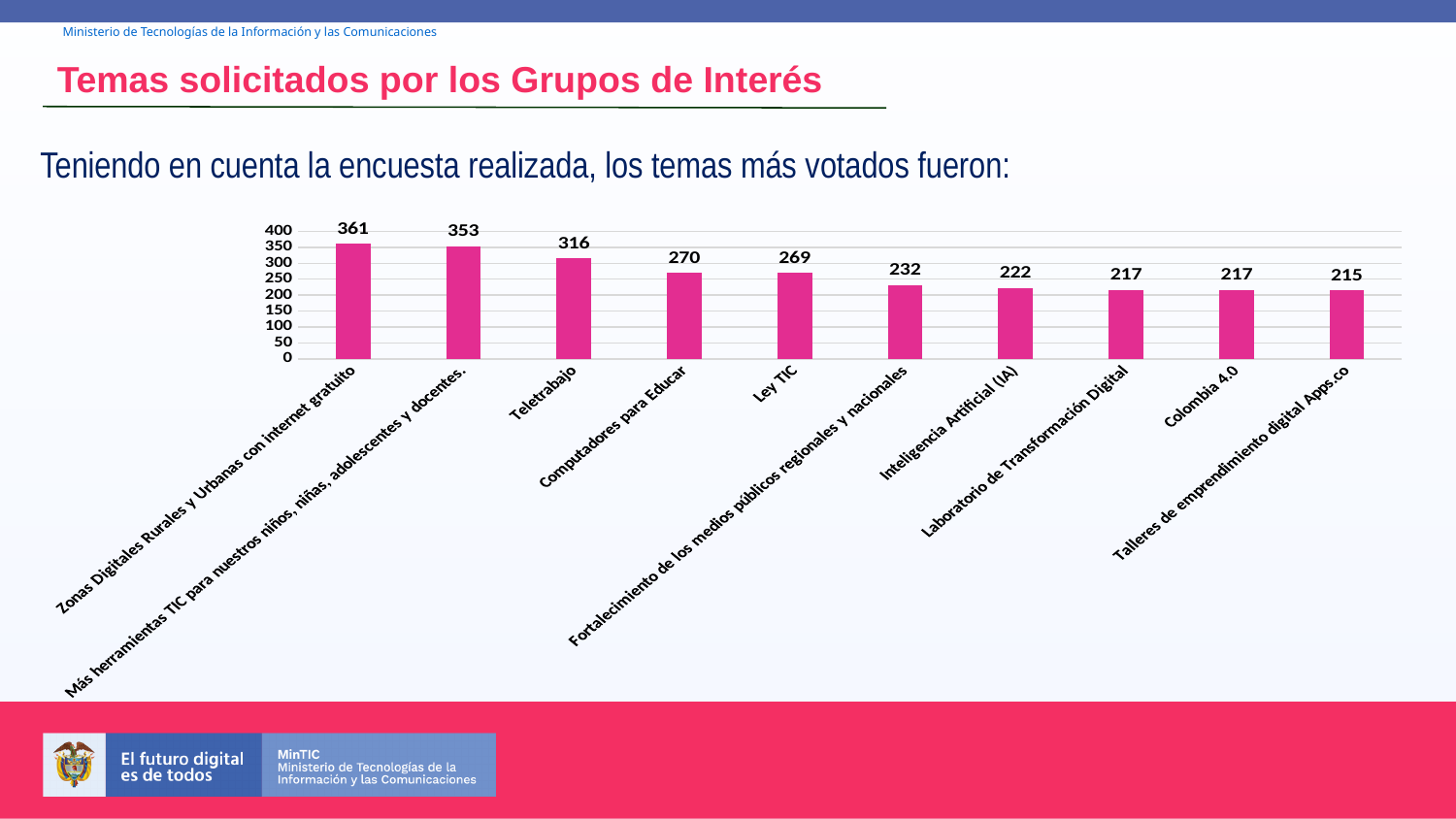
How many categories are shown in the chart? 10 What is the difference between the values for Zonas Digitales Rurales y Urbanas con internet gratuito and Teletrabajo? 45 Is the value for Fortalecimiento de los medios públicos regionales y nacionales greater or less than 300? less What is the value for Más herramientas TIC para nuestros niños, niñas, adolescentes y docentes? 353 What is the value for Colombia 4.0? 217 What is the value for Teletrabajo? 316 Which category has the lowest value? Talleres de emprendimiento digital Apps.co What kind of chart is shown on the slide? bar chart What is the value for Ley TIC? 269 Which category has the highest value? Zonas Digitales Rurales y Urbanas con internet gratuito Do the values rise or fall from left to right along the x axis? fall Which is larger, the value for Computadores para Educar or the value for Inteligencia Artificial (IA)? Computadores para Educar